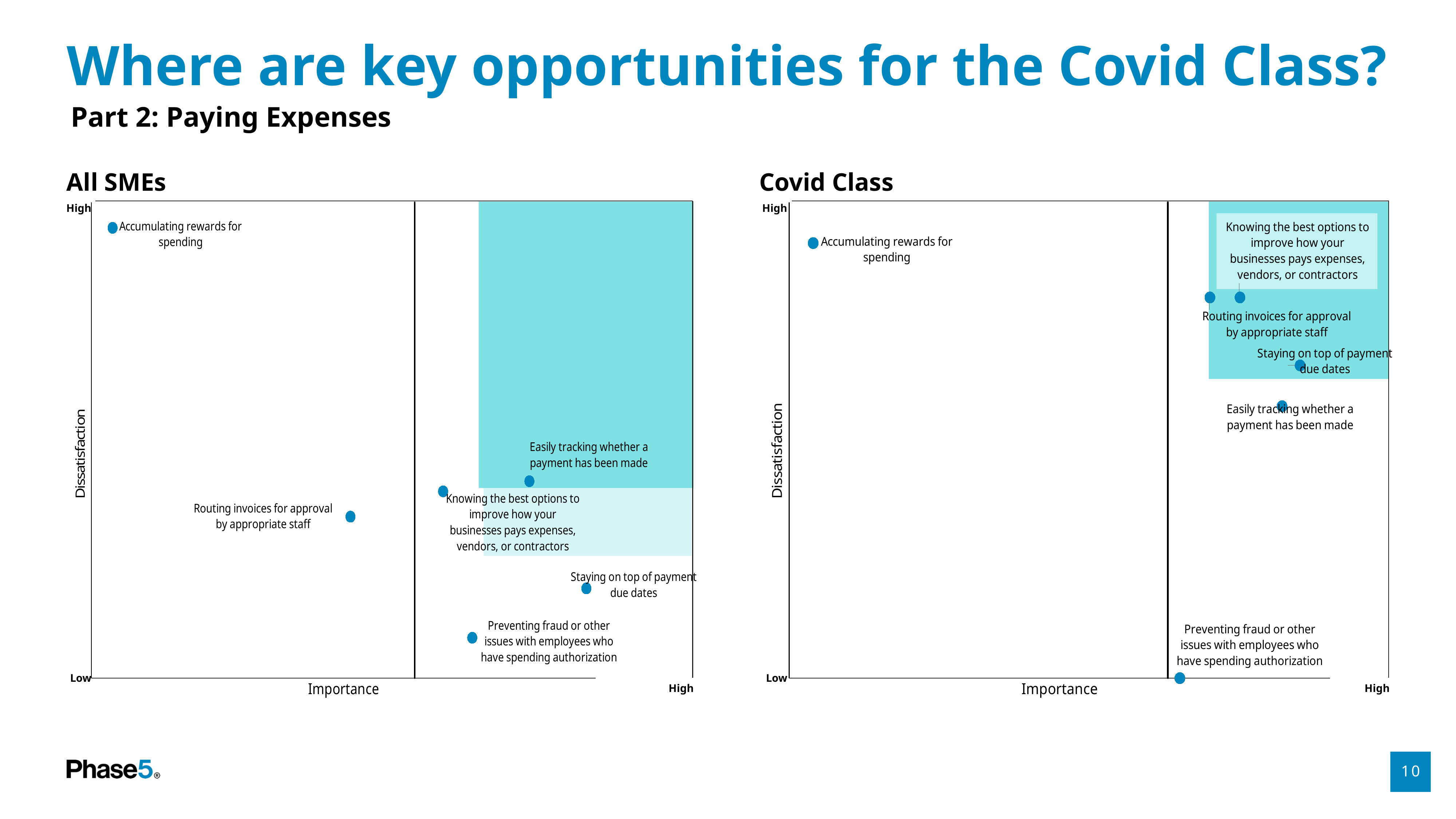
On the All SMEs chart, which item has the highest importance? Staying on top of payment due dates On the Covid Class chart, which item has the lowest importance? Accumulating rewards for spending How many data points are plotted on the All SMEs chart? 6 How many data points are plotted on the Covid Class chart? 6 On the Covid Class chart, which item has the lowest dissatisfaction? Preventing fraud or other issues with employees who have spending authorization On the All SMEs chart, which item has the lowest dissatisfaction? Preventing fraud or other issues with employees who have spending authorization What kind of chart is the All SMEs chart? Scatter chart What is the label of the vertical axis on the All SMEs chart? Dissatisfaction On the All SMEs chart, which item has the highest dissatisfaction? Accumulating rewards for spending What is the label of the horizontal axis on the Covid Class chart? Importance On the Covid Class chart, which has higher dissatisfaction: Routing invoices for approval by appropriate staff or Easily tracking whether a payment has been made? Routing invoices for approval by appropriate staff On the All SMEs chart, which has higher dissatisfaction: Easily tracking whether a payment has been made or Staying on top of payment due dates? Easily tracking whether a payment has been made